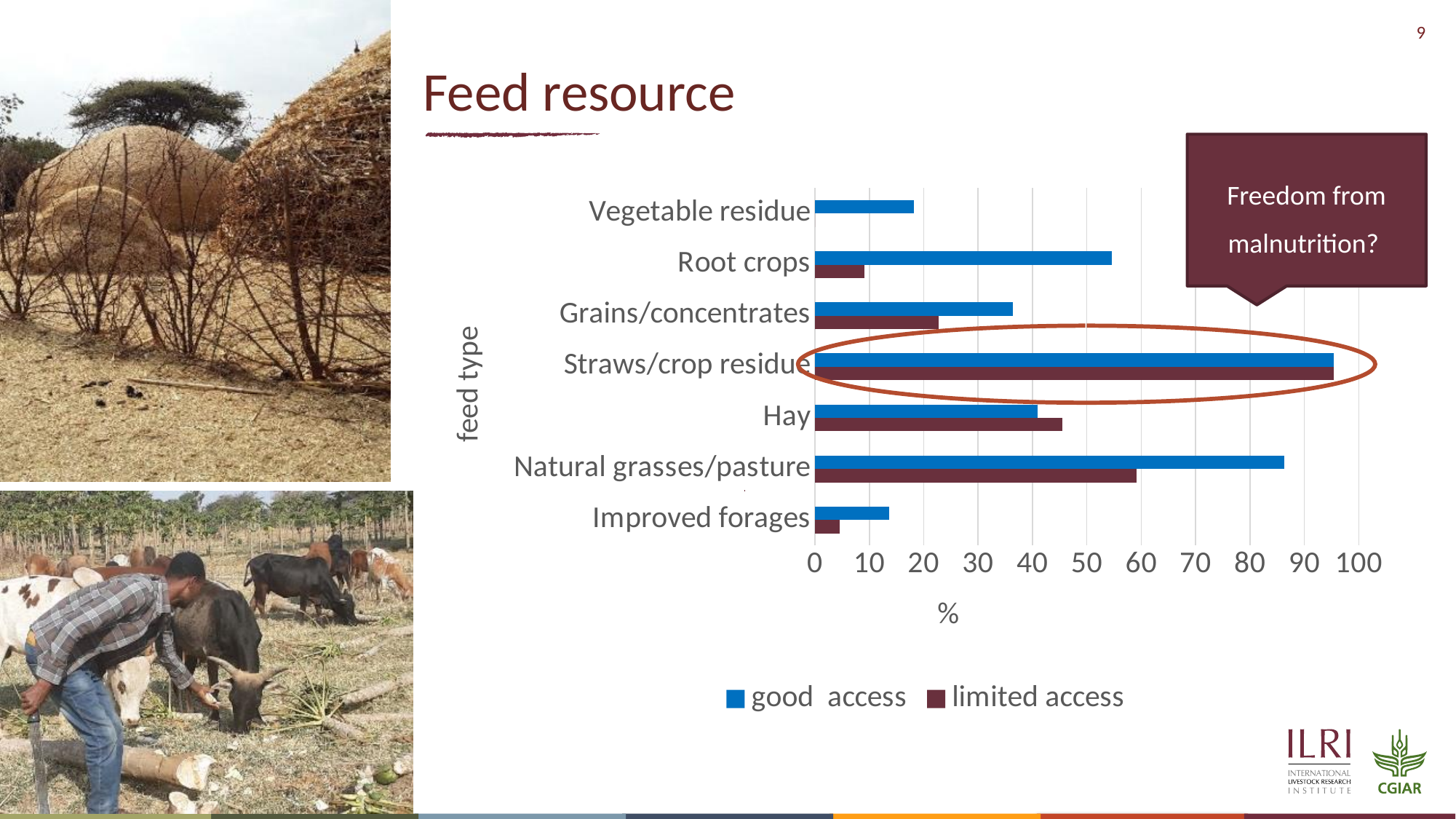
For Hay, which is larger: good access or limited access? limited access Which feed type has the highest value for good access? Straws/crop residue Is the good access value for Root crops greater or less than 50? greater Is the good access value for Natural grasses/pasture greater or less than 80? greater Which feed type has the highest value for limited access? Straws/crop residue Is the limited access value for Improved forages greater or less than 10? less How many series does the legend list? 2 What is the label of the x axis? % How many feed types are listed on the chart? 7 For Natural grasses/pasture, which is larger: good access or limited access? good access What type of chart is shown on the slide? bar chart